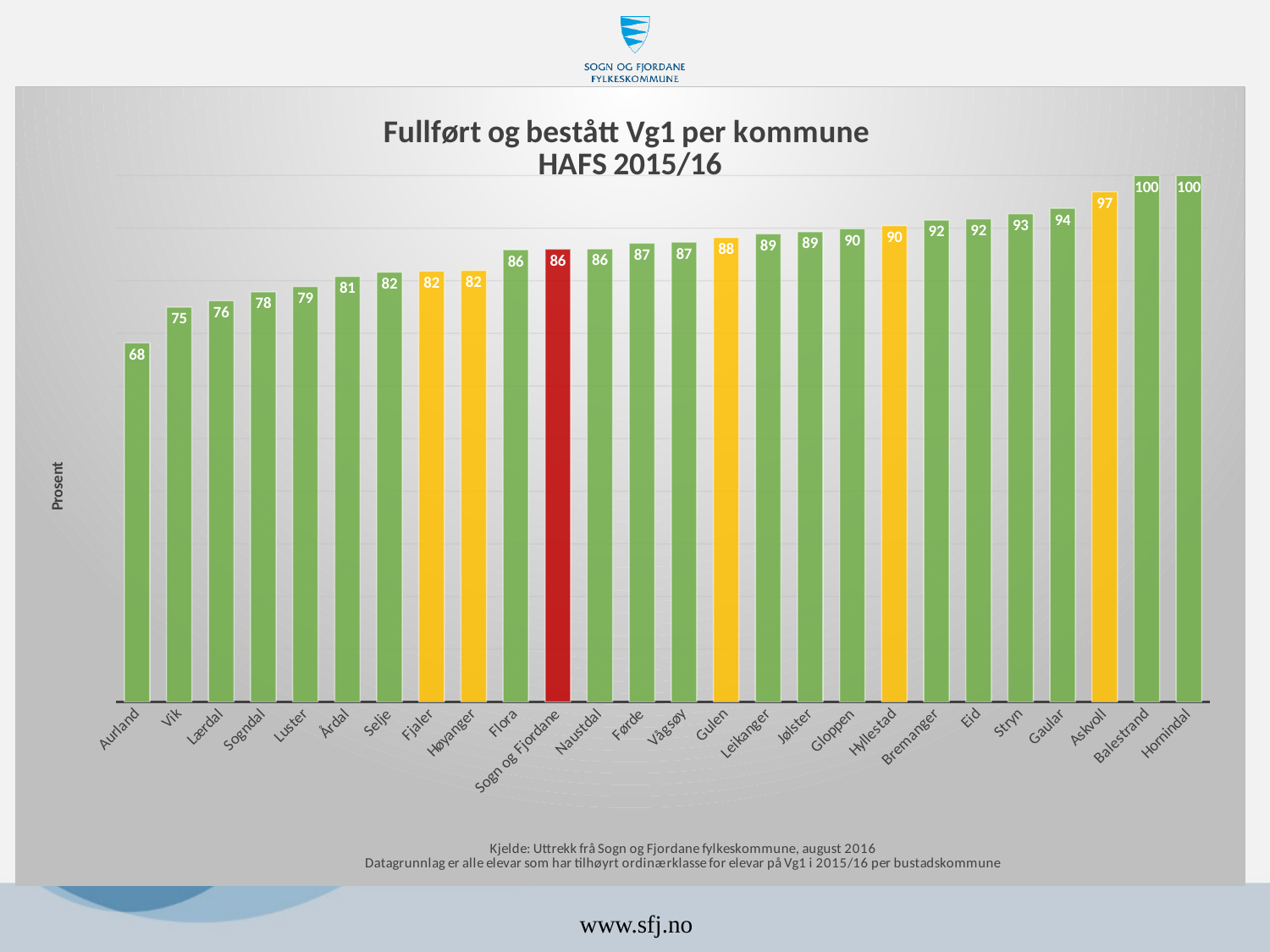
Which kommunes have the highest value? Balestrand and Hornindal What is the value for Sogn og Fjordane? 86 What kind of chart is shown on the slide? Bar chart What is the difference between the values for Stryn and Vik? 18 How many bars are shown in the chart? 26 Which kommune has the lowest value? Aurland Which has a larger value, Gulen or Fjaler? Gulen Which bar is coloured red? Sogn og Fjordane What is the value for Aurland? 68 What is the difference between the values for Hornindal and Aurland? 32 What is the value for Askvoll? 97 Do the values rise or fall from left to right along the x axis? Rise